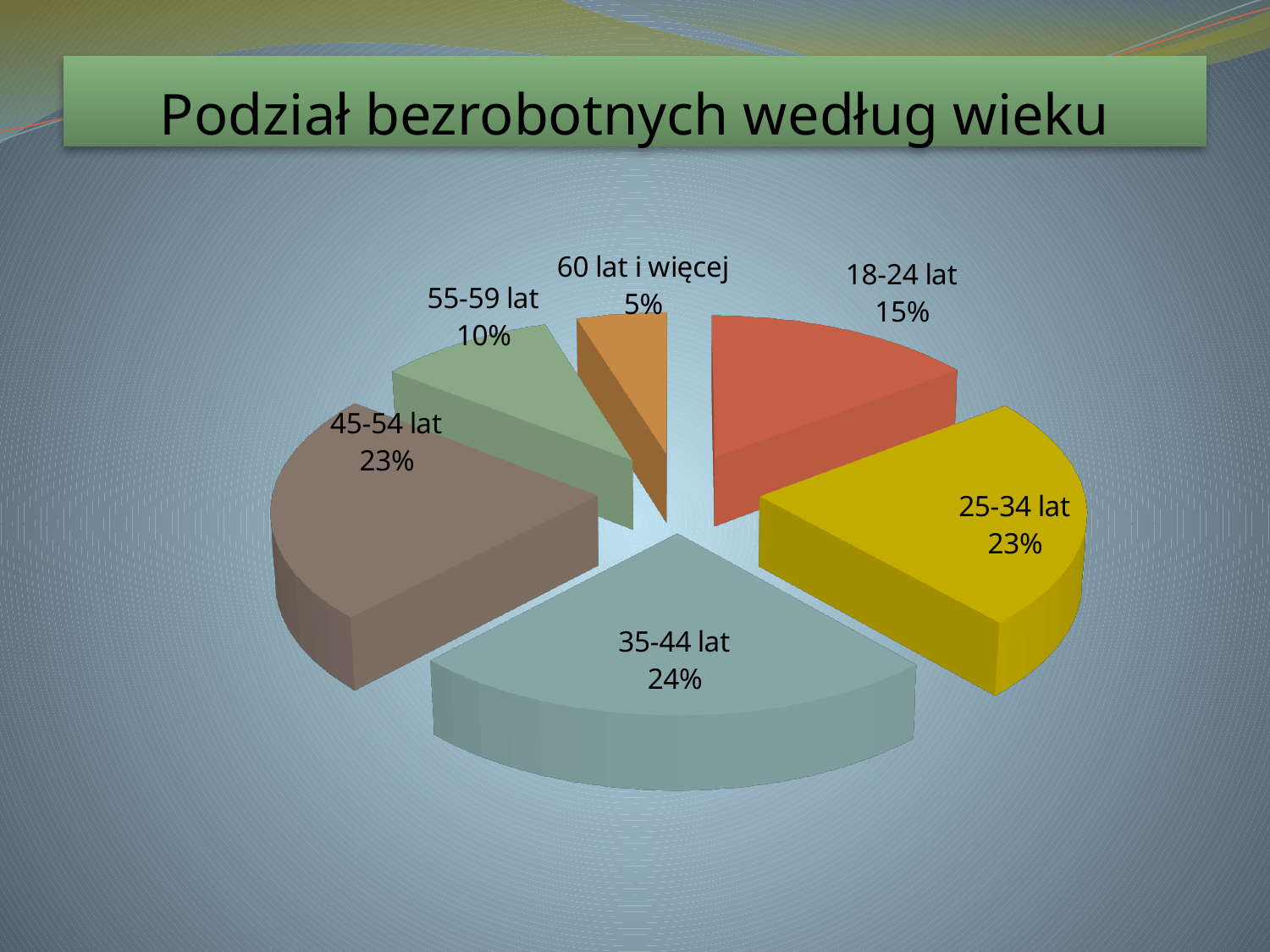
Which age group has the largest share of the pie? 35-44 lat What share of the pie is the 35-44 lat slice? 24% What share of the pie is the 18-24 lat slice? 15% What is the difference in percentage points between the 25-34 lat slice and the 18-24 lat slice? 8 Which slice is larger, 45-54 lat or 55-59 lat? 45-54 lat What colour is the 25-34 lat slice? yellow What is the title of the chart on the slide? Podział bezrobotnych według wieku How many slices does the pie chart have? 6 What kind of chart is shown on the slide? pie chart Which age group has the smallest share of the pie? 60 lat i więcej What share of the pie is the 55-59 lat slice? 10%